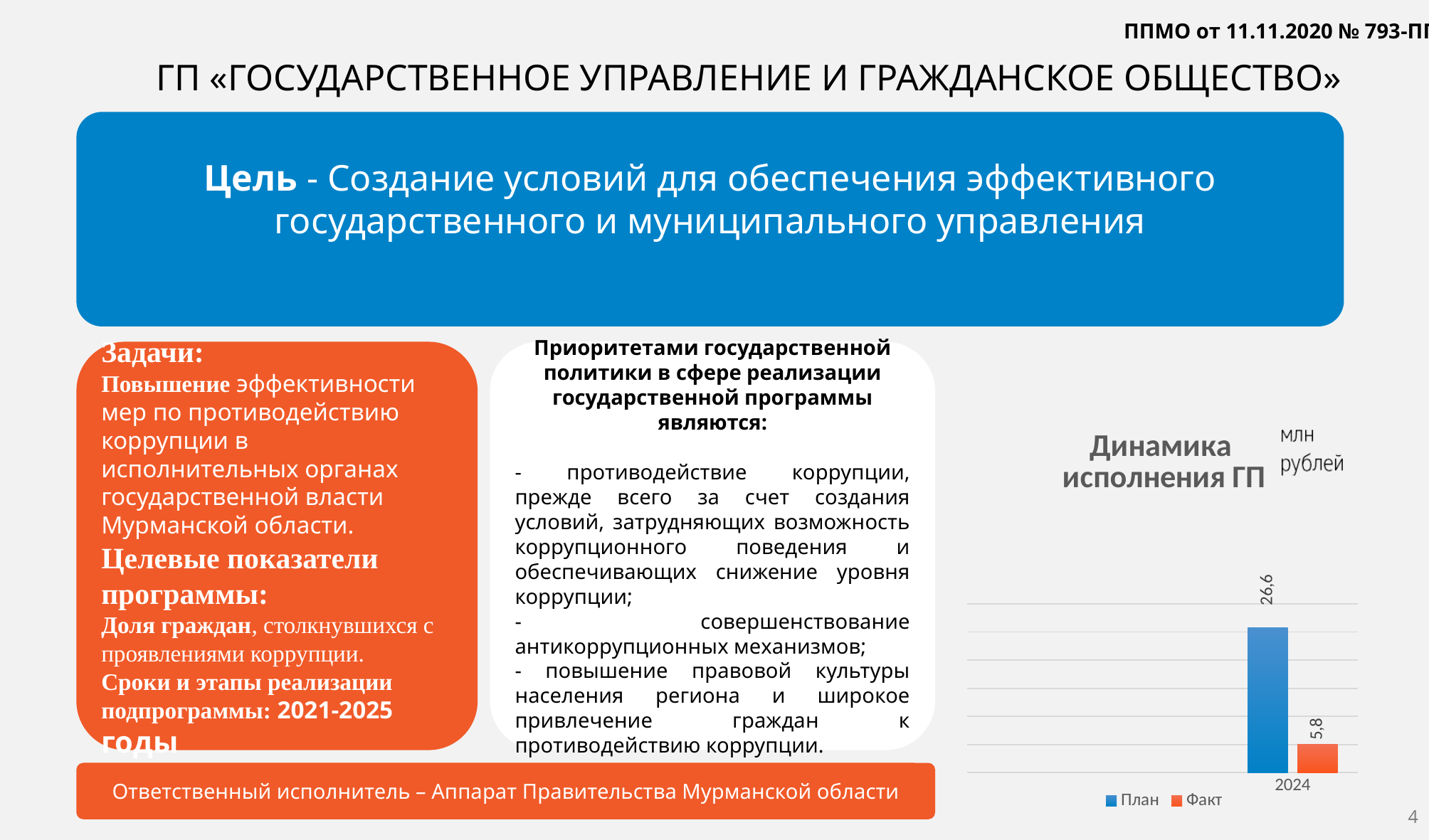
What is the value of Факт for 2024 in the chart "Динамика исполнения ГП"? 5,8 What kind of chart is "Динамика исполнения ГП"? bar chart How many categories are shown on the x axis of the chart "Динамика исполнения ГП"? 1 How many series does the legend of the chart "Динамика исполнения ГП" list? 2 What is the difference between План and Факт for 2024 in the chart "Динамика исполнения ГП"? 20,8 Which year is shown on the x axis of the chart "Динамика исполнения ГП"? 2024 Which series is the lowest for 2024 in the chart "Динамика исполнения ГП"? Факт Which series is the highest for 2024 in the chart "Динамика исполнения ГП"? План What is the value of План for 2024 in the chart "Динамика исполнения ГП"? 26,6 Which series has the higher value for 2024 in the chart "Динамика исполнения ГП", План or Факт? План What unit is indicated next to the title of the chart "Динамика исполнения ГП"? млн рублей